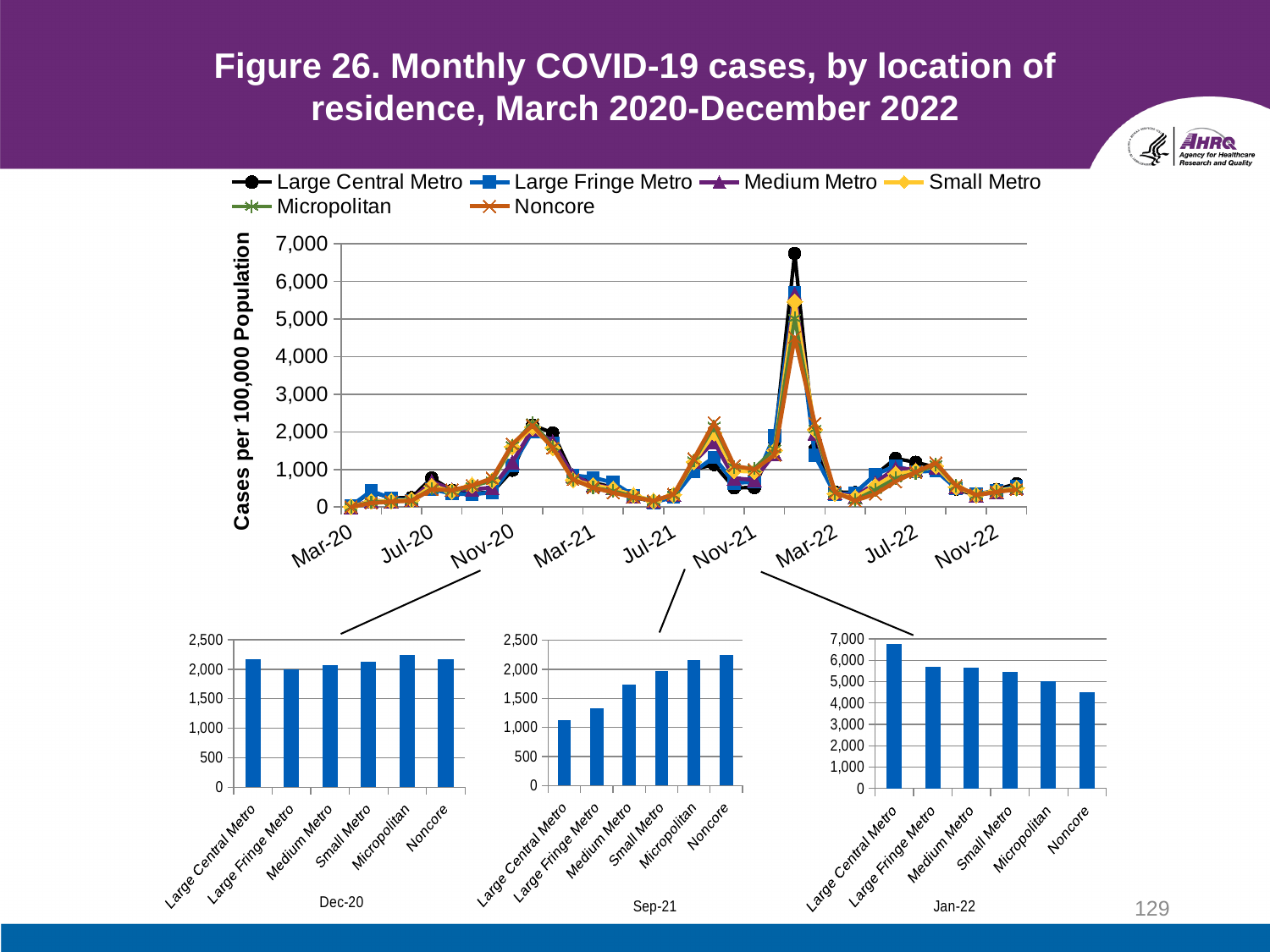
In the Jan-22 bar chart, is the value for Noncore greater or less than 5,000? less How many series does the legend of the main line chart list? 6 In the Sep-21 bar chart, is the value for Large Central Metro greater or less than 1,500? less How many locations are shown in the Dec-20 bar chart? 6 In the Dec-20 bar chart, is the value for Large Fringe Metro greater or less than 1,500? greater In the Sep-21 bar chart, do the values rise or fall from Large Central Metro to Noncore? rise In the Jan-22 bar chart, which location has the highest value? Large Central Metro What kind of chart is the Jan-22 chart at the bottom right of the slide? bar chart In the Jan-22 bar chart, which location has the lowest value? Noncore In the Sep-21 bar chart, which location has the lowest value? Large Central Metro What kind of chart is the main chart at the top of the slide? line chart